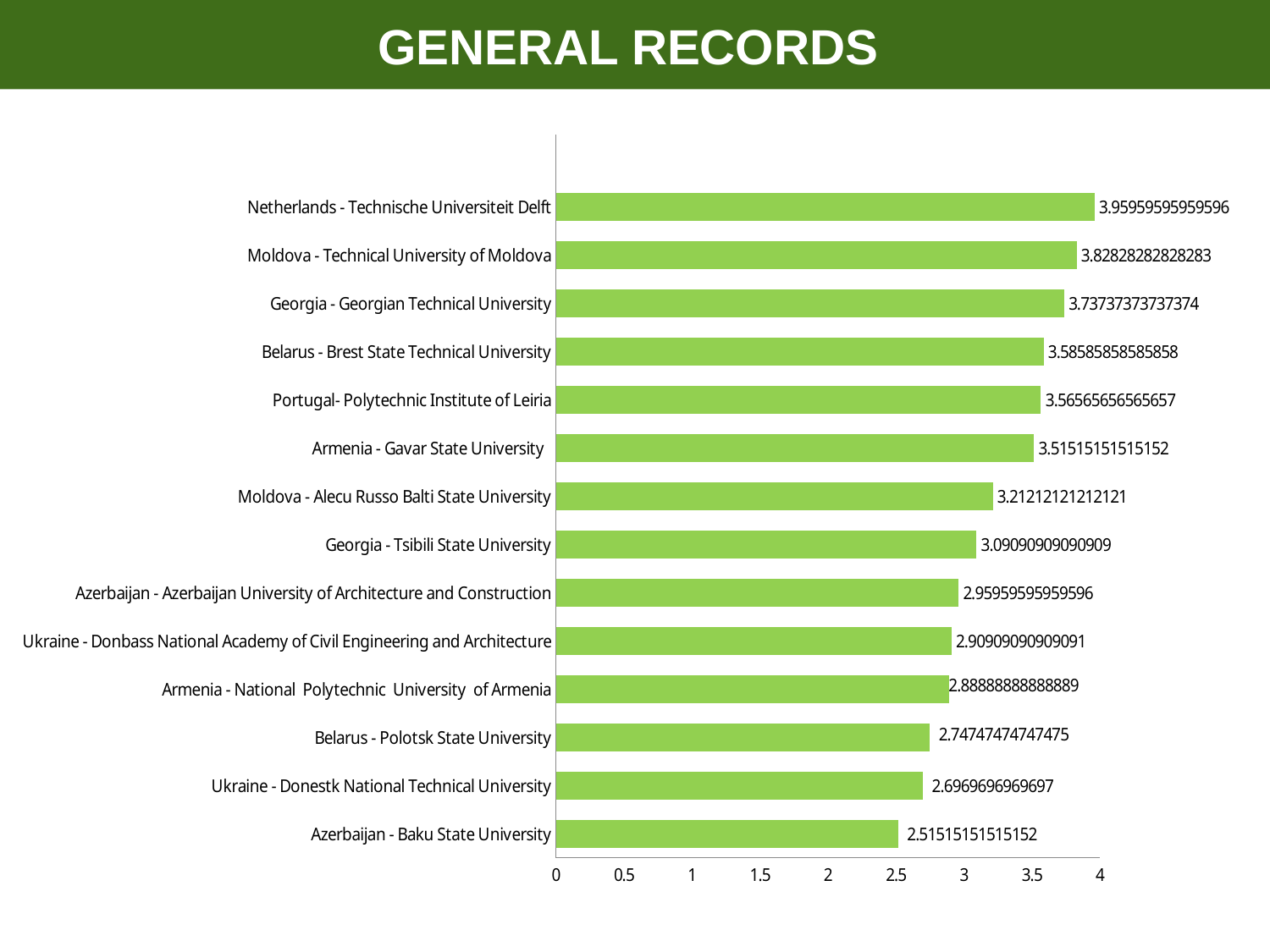
What is the difference between the values for Netherlands - Technische Universiteit Delft and Azerbaijan - Baku State University? 1.44444444444444 Which university has the highest value? Netherlands - Technische Universiteit Delft How many universities are shown in the chart? 14 What is the value for Ukraine - Donestk National Technical University? 2.6969696969697 What is the title of the slide? GENERAL RECORDS Which university has the lowest value? Azerbaijan - Baku State University What kind of chart is shown on the slide? bar chart What is the value for Azerbaijan - Baku State University? 2.51515151515152 What is the value for Netherlands - Technische Universiteit Delft? 3.95959595959596 Is the value for Belarus - Polotsk State University greater or less than 3? less Which has a larger value: Moldova - Alecu Russo Balti State University or Georgia - Tsibili State University? Moldova - Alecu Russo Balti State University What is the value for Armenia - Gavar State University? 3.51515151515152